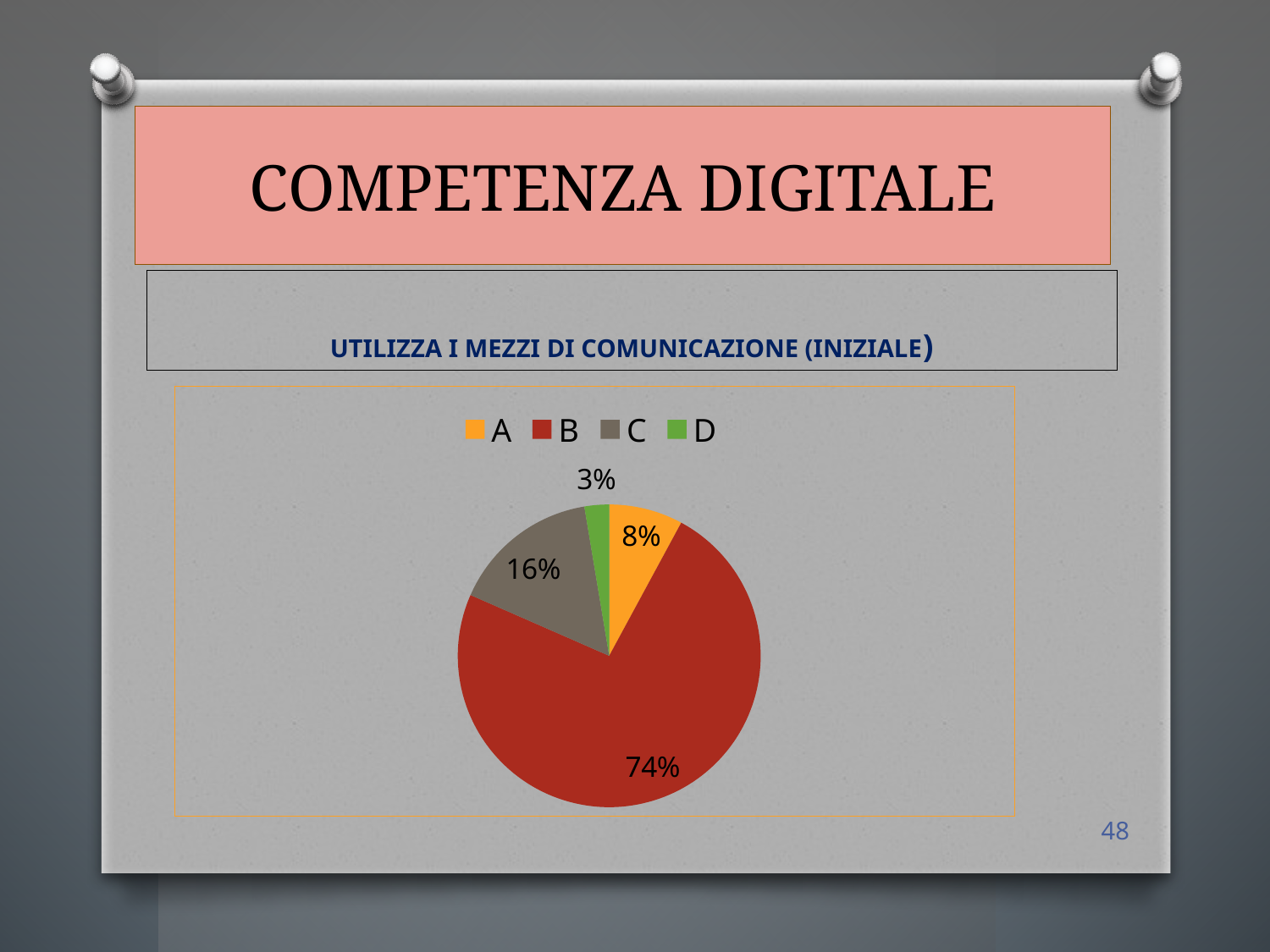
What colour is the slice for category B? red What percentage does slice C represent? 16% What percentage does slice A represent? 8% What is the difference in percentage points between slice B and slice C? 58 Which category has the smallest share of the pie? D What percentage does slice D represent? 3% What kind of chart is shown on the slide? pie chart How many entries does the legend list? 4 Which category has the largest share of the pie? B Which is larger, slice A or slice C? C How many slices does the pie chart have? 4 What percentage does slice B represent? 74%